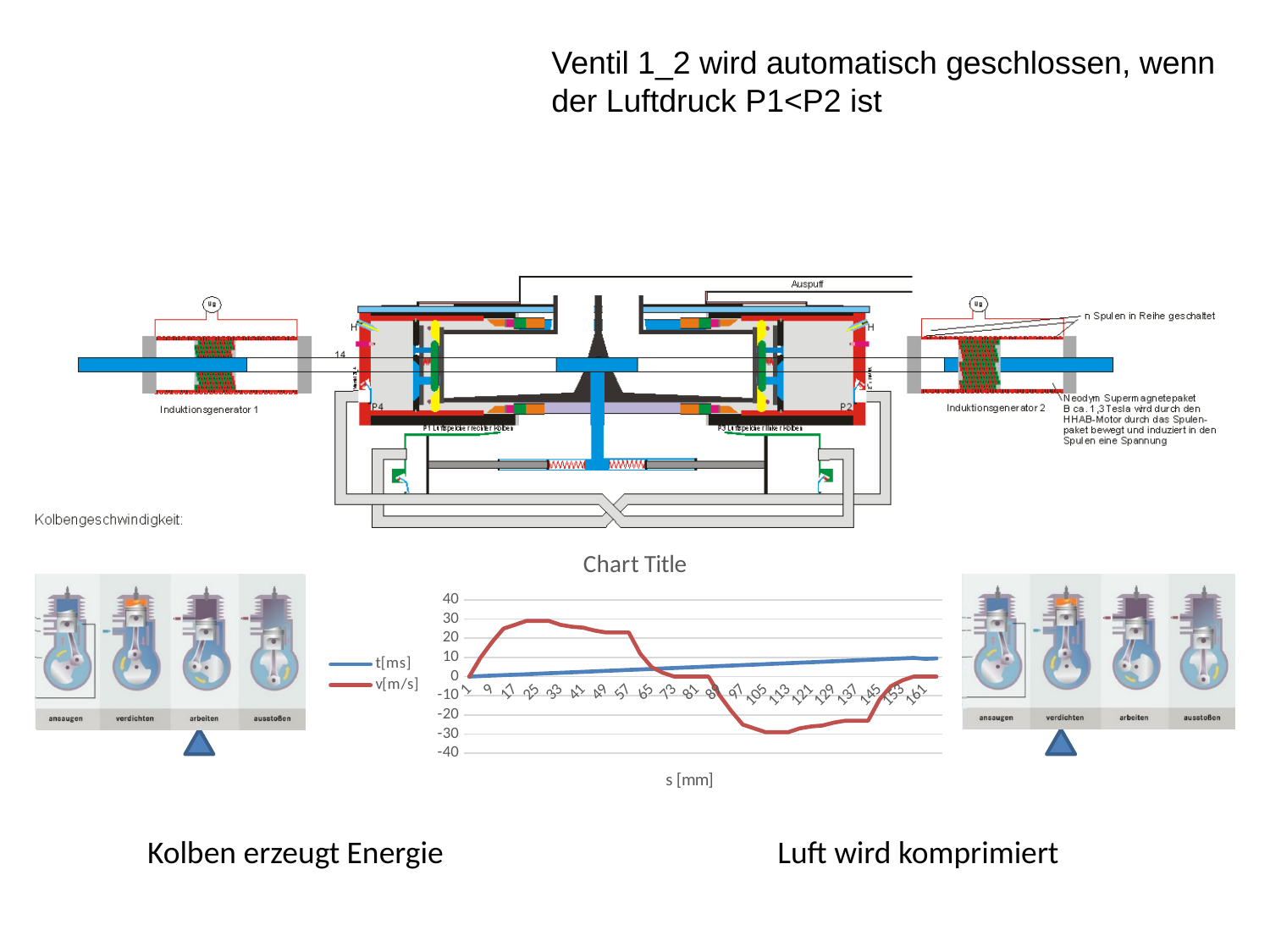
What label is shown on the x axis of the chart? s [mm] Is the value of v[m/s] at s = 105 greater or less than -20? less Is the value of t[ms] at s = 161 greater or less than 20? less What kind of chart is shown on the slide? line chart What is the title of the chart? Chart Title Is the value of v[m/s] at s = 25 greater or less than 20? greater Which series is larger at s = 113, t[ms] or v[m/s]? t[ms] Does the v[m/s] series rise or fall between s = 57 and s = 105? fall Which series is larger at s = 25, t[ms] or v[m/s]? v[m/s] How many series does the chart legend list? 2 Does the t[ms] series rise or fall along the x axis? rise